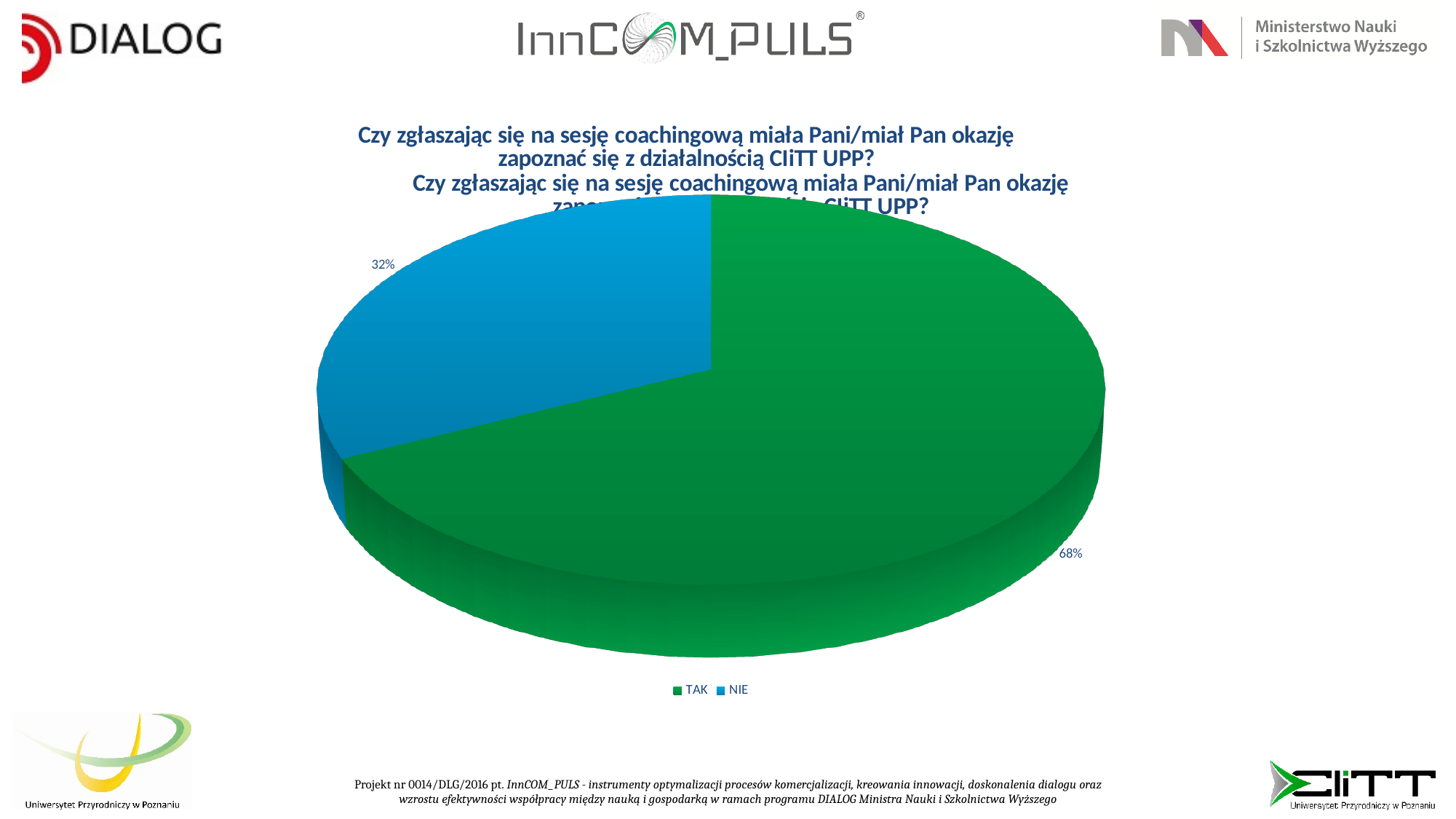
Which is larger, the share for TAK or the share for NIE? TAK What colour is the NIE slice? blue What colour is the TAK slice? green What kind of chart is shown on the slide? pie chart What percentage of the pie is labelled TAK? 68% Which category has the largest share of the pie? TAK How many categories does the legend list? 2 Which category has the smallest share of the pie? NIE What percentage of the pie is labelled NIE? 32% What is the difference in percentage points between TAK and NIE? 36 How many slices does the pie chart have? 2